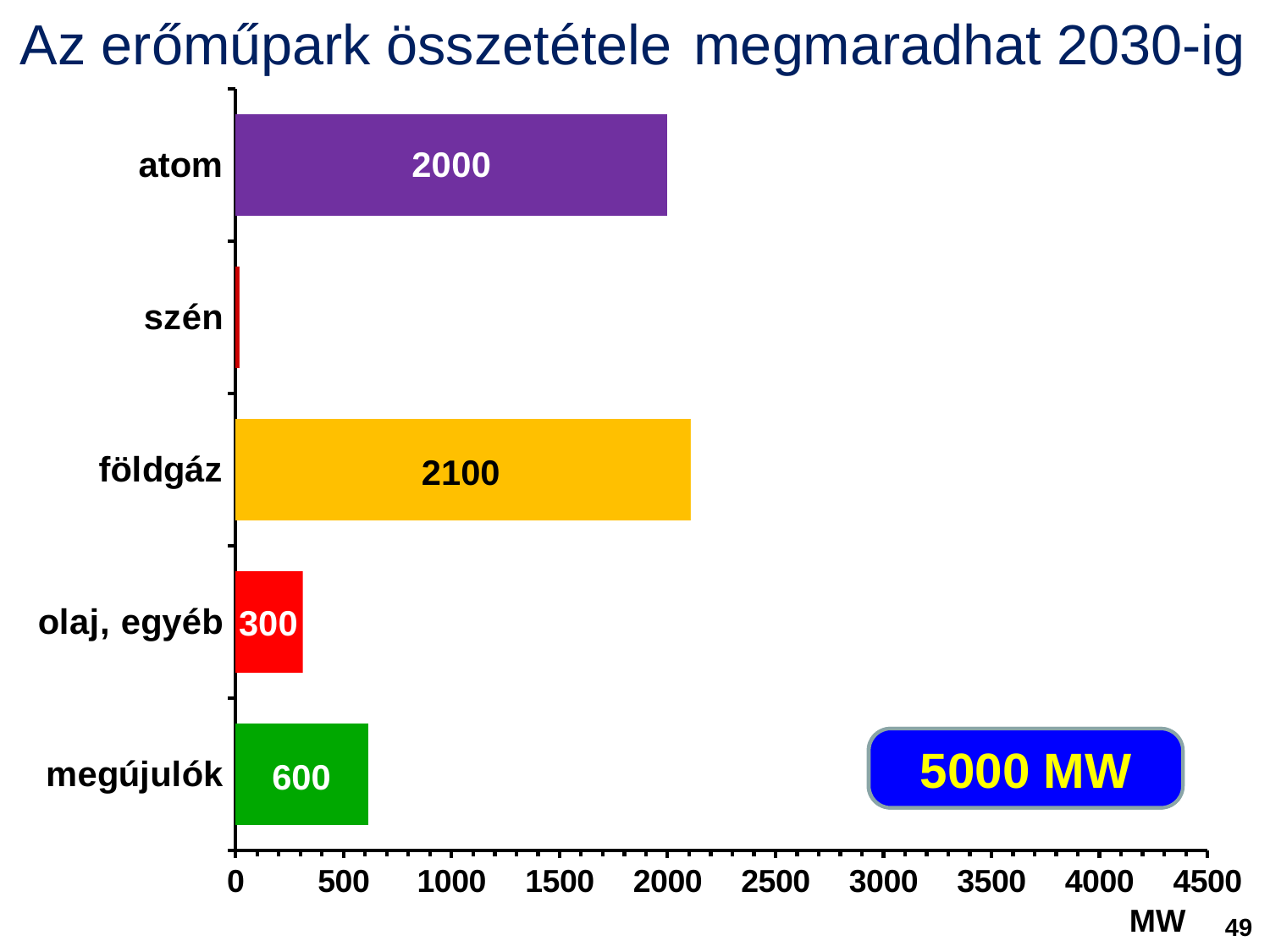
Which is larger, the value for megújulók or the value for olaj, egyéb? megújulók What is the value for földgáz? 2100 Which category has the lowest value? szén How many categories are shown in the chart? 5 What is the difference between the values for megújulók and olaj, egyéb? 300 What is the value for atom? 2000 What kind of chart is shown on the slide? bar chart What is the value for megújulók? 600 Which category has the highest value? földgáz Is the value for szén greater or less than 500? less What is the difference between the values for földgáz and atom? 100 What is the value for olaj, egyéb? 300